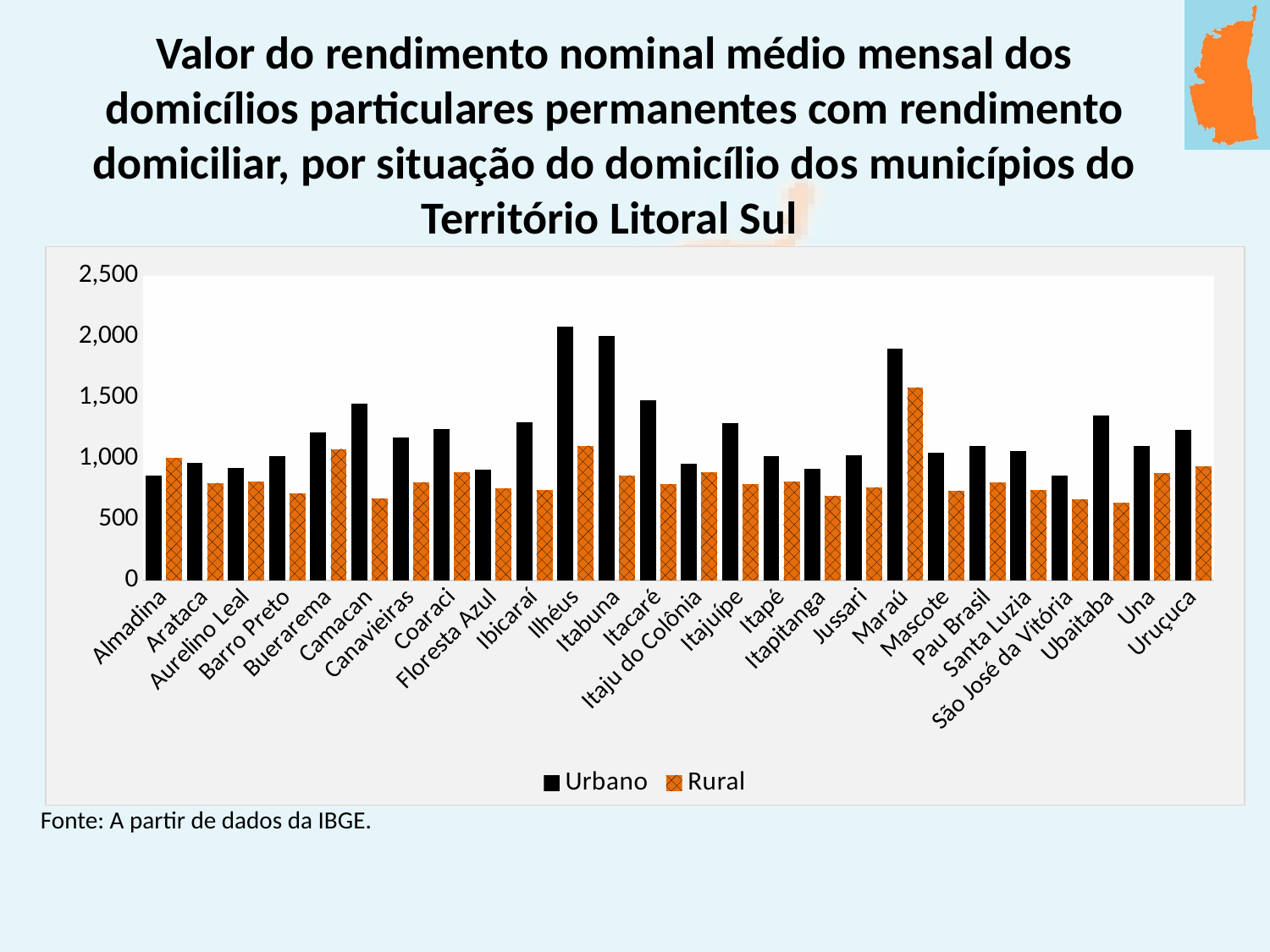
What kind of chart is shown on the slide? bar chart How many series does the legend list? 2 Is the Rural value for Maraú greater or less than 1,500? greater How many municipalities are shown on the x axis? 26 Which is larger, the Urbano value for Ubaitaba or the Urbano value for Una? Ubaitaba Is the Urbano value for Camacan greater or less than 1,500? less For Almadina, which is larger, the Urbano value or the Rural value? Rural Is the Rural value for Itabuna greater or less than 1,000? less Which municipality has the highest Urbano value? Ilhéus What is the source cited below the chart? A partir de dados da IBGE. Which municipality has the highest Rural value? Maraú